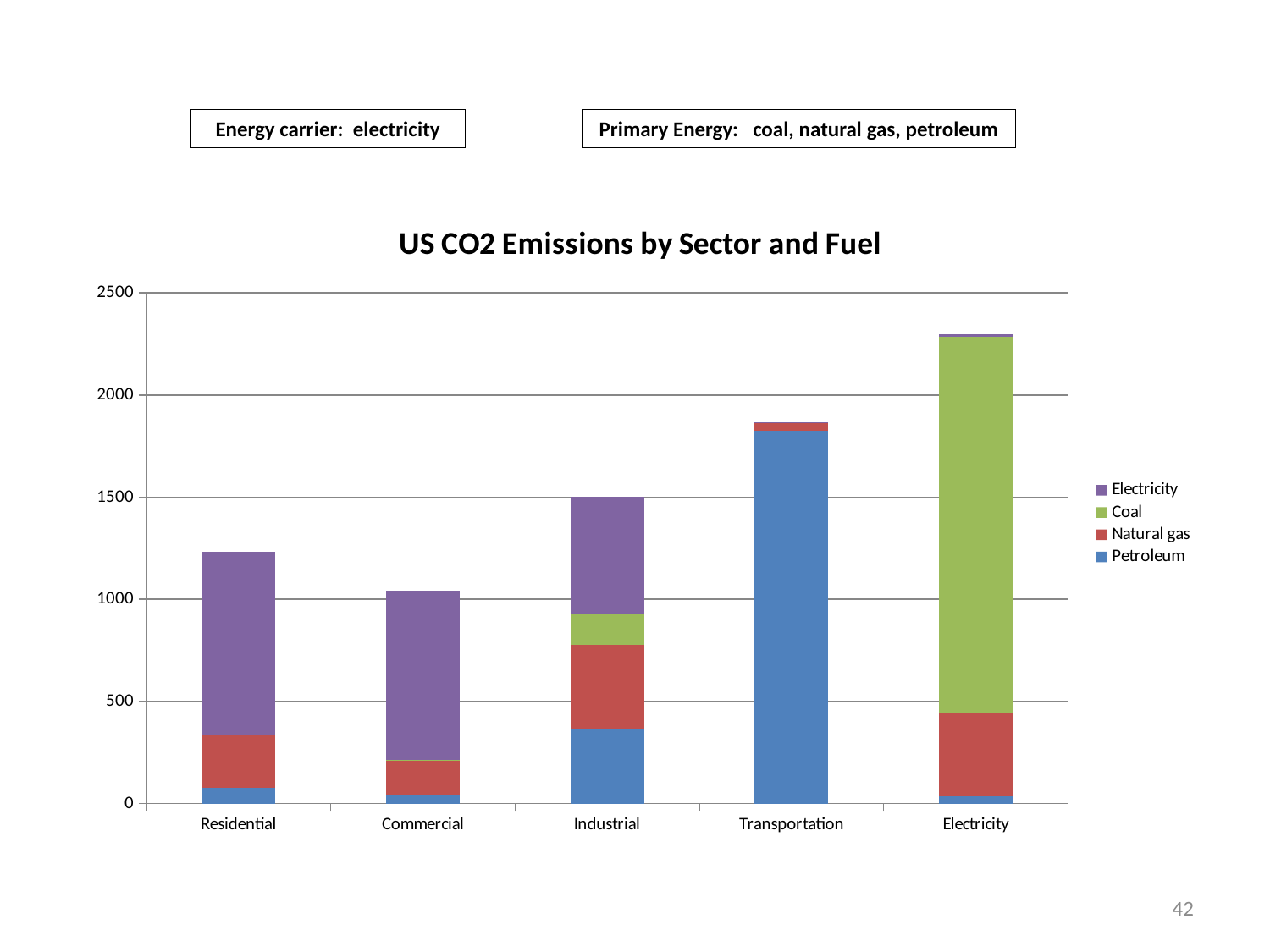
How many series does the chart's legend list? 4 Is the total bar for Transportation greater or less than 2000? less Which sector has a taller total bar, Transportation or Industrial? Transportation What kind of chart is shown on the slide? Stacked bar chart Is the total bar for Electricity greater or less than 2000? greater What is the title of the chart? US CO2 Emissions by Sector and Fuel Is the total bar for Residential greater or less than 1000? greater Which sector has the tallest stacked bar in the chart? Electricity Which sector has the shortest stacked bar in the chart? Commercial How many sectors are shown along the x axis of the chart? 5 Which fuel series makes up most of the Transportation bar? Petroleum